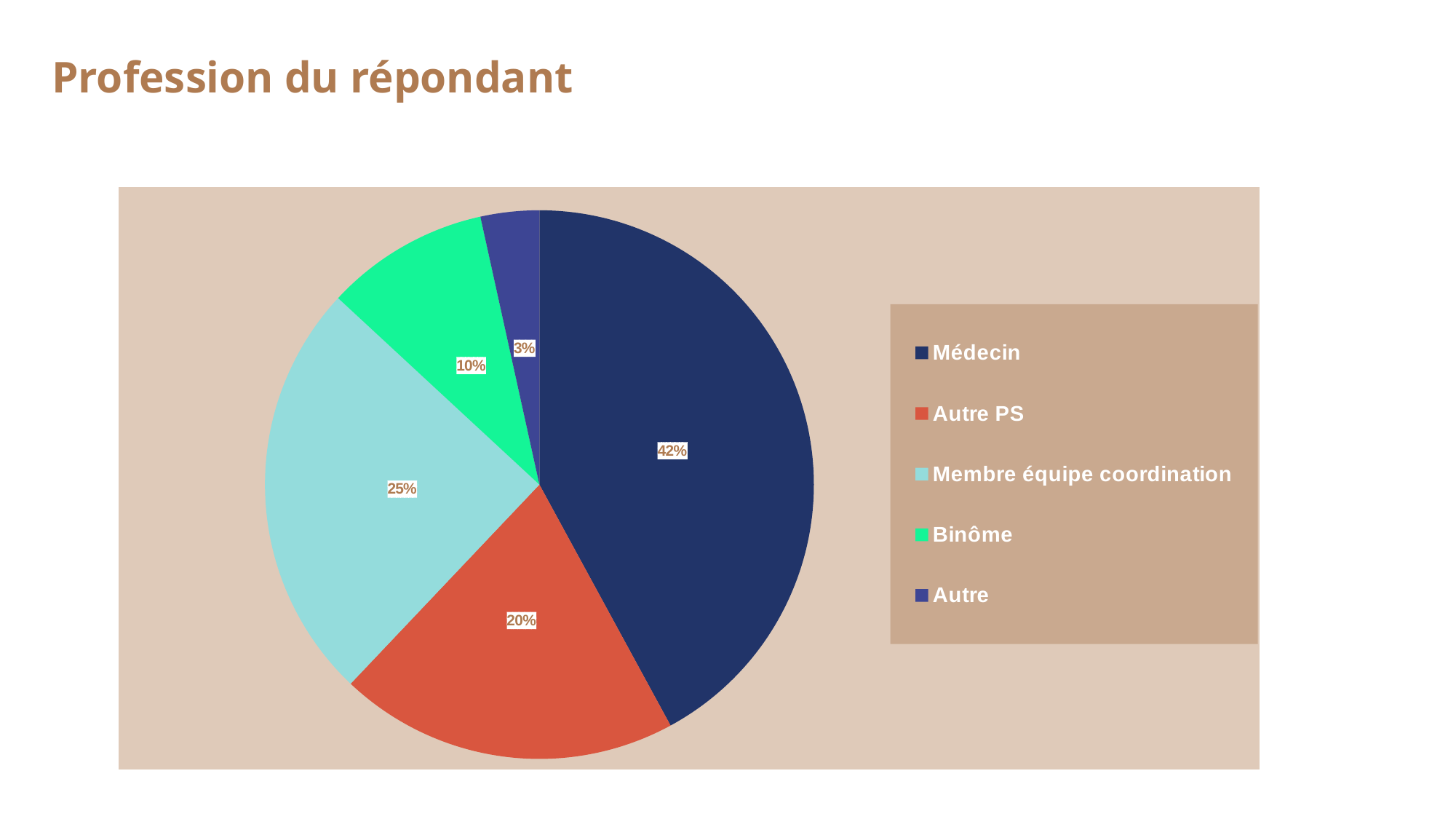
How many categories does the legend list? 5 What is the value shown for Binôme? 10% What is the title of the chart? Profession du répondant Which category has the smallest slice of the pie? Autre What kind of chart is shown on the slide? pie chart What is the value shown for Autre PS? 20% Which is larger, the share for Membre équipe coordination or the share for Binôme? Membre équipe coordination What is the value shown for Autre? 3% What share of the pie does Médecin represent? 42% Which category has the largest slice of the pie? Médecin What is the value shown for Membre équipe coordination? 25% What is the difference between the Médecin and Autre PS shares? 22%